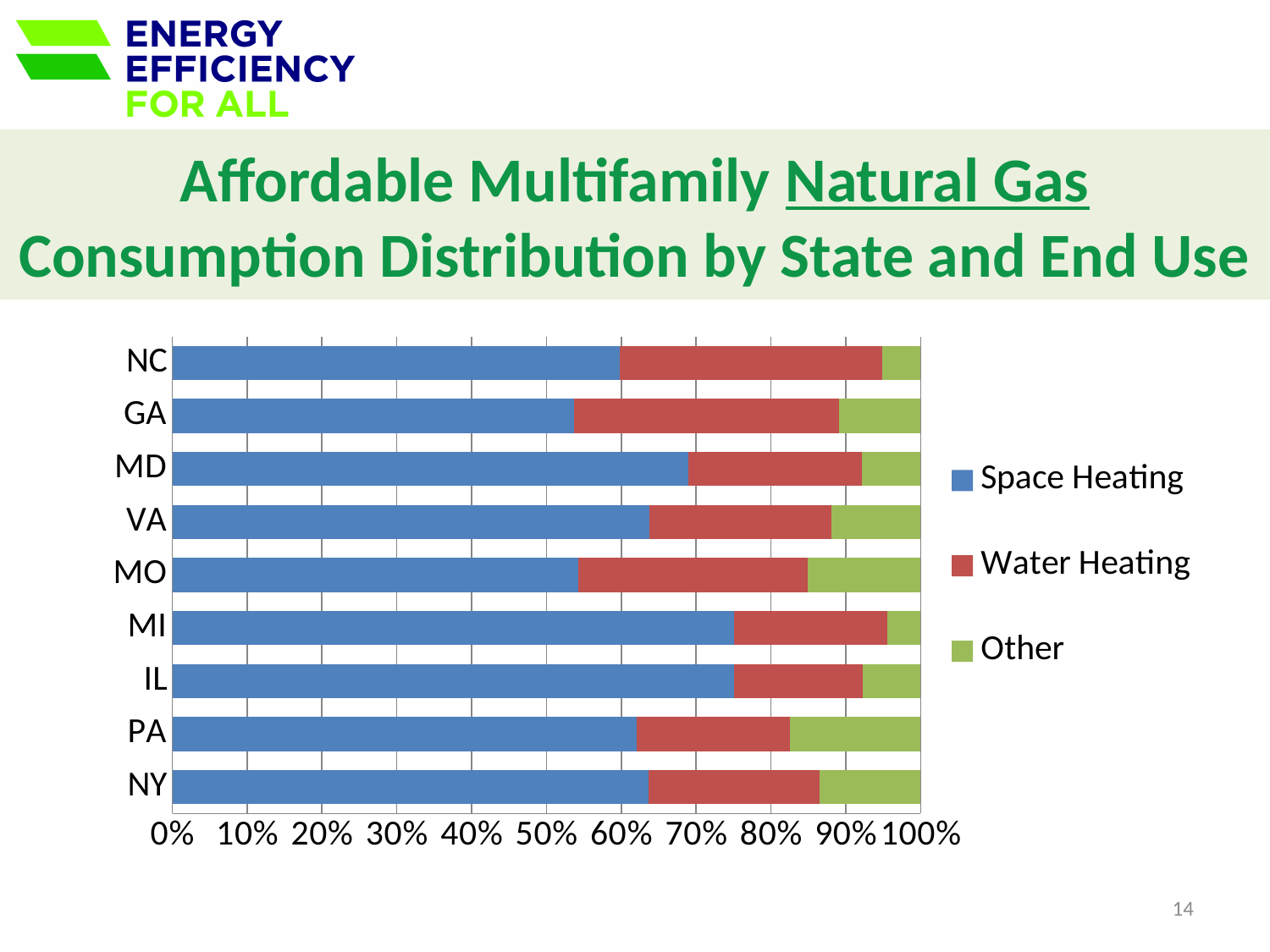
Is the Space Heating share for MD greater or less than 60%? greater Which end uses are listed in the chart legend? Space Heating, Water Heating, Other Which state has the larger Water Heating share, GA or IL? GA Is the Space Heating share for GA greater or less than 60%? less Which state has the larger Other share, PA or NC? PA How many states are listed on the vertical axis of the chart? 9 Which state has the larger Space Heating share, MD or GA? MD Is the Space Heating share for MI greater or less than 70%? greater What kind of chart is shown on the slide? Stacked bar chart How many series does the chart legend list? 3 What colour represents Space Heating in the chart? Blue